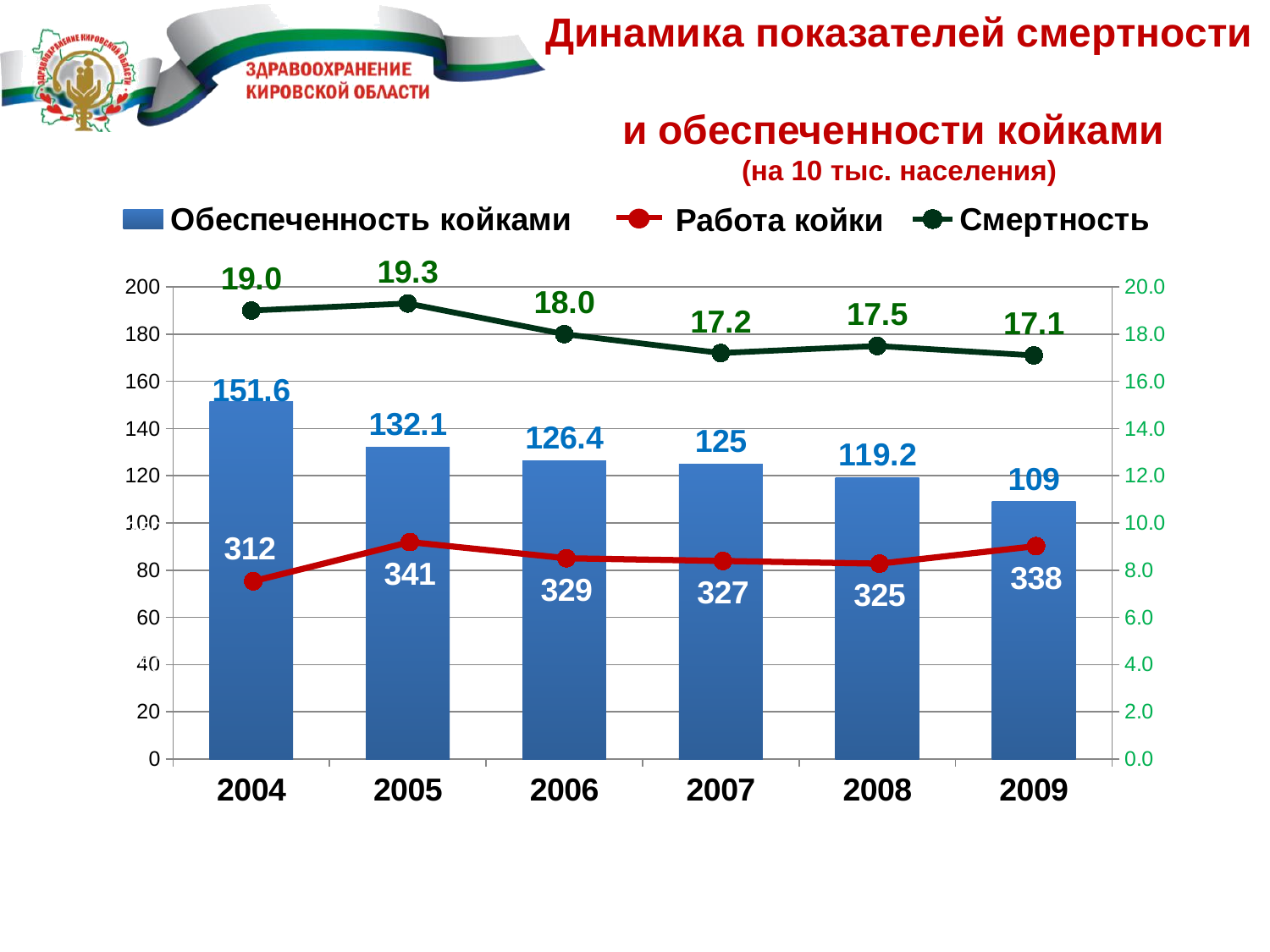
In which year is Обеспеченность койками the lowest? 2009 What is the value of Смертность for 2007? 17.2 In which year is Смертность the highest? 2005 What is the value of Обеспеченность койками for 2004? 151.6 What is the value of Работа койки for 2005? 341 How many years are shown on the x axis? 6 How many series does the legend list? 3 In which year is Работа койки the lowest? 2004 What is the difference between Обеспеченность койками in 2004 and in 2009? 42.6 What colour is the Работа койки line? red Which is larger, Смертность in 2008 or in 2009? 2008 Does Обеспеченность койками rise or fall from 2004 to 2009? fall